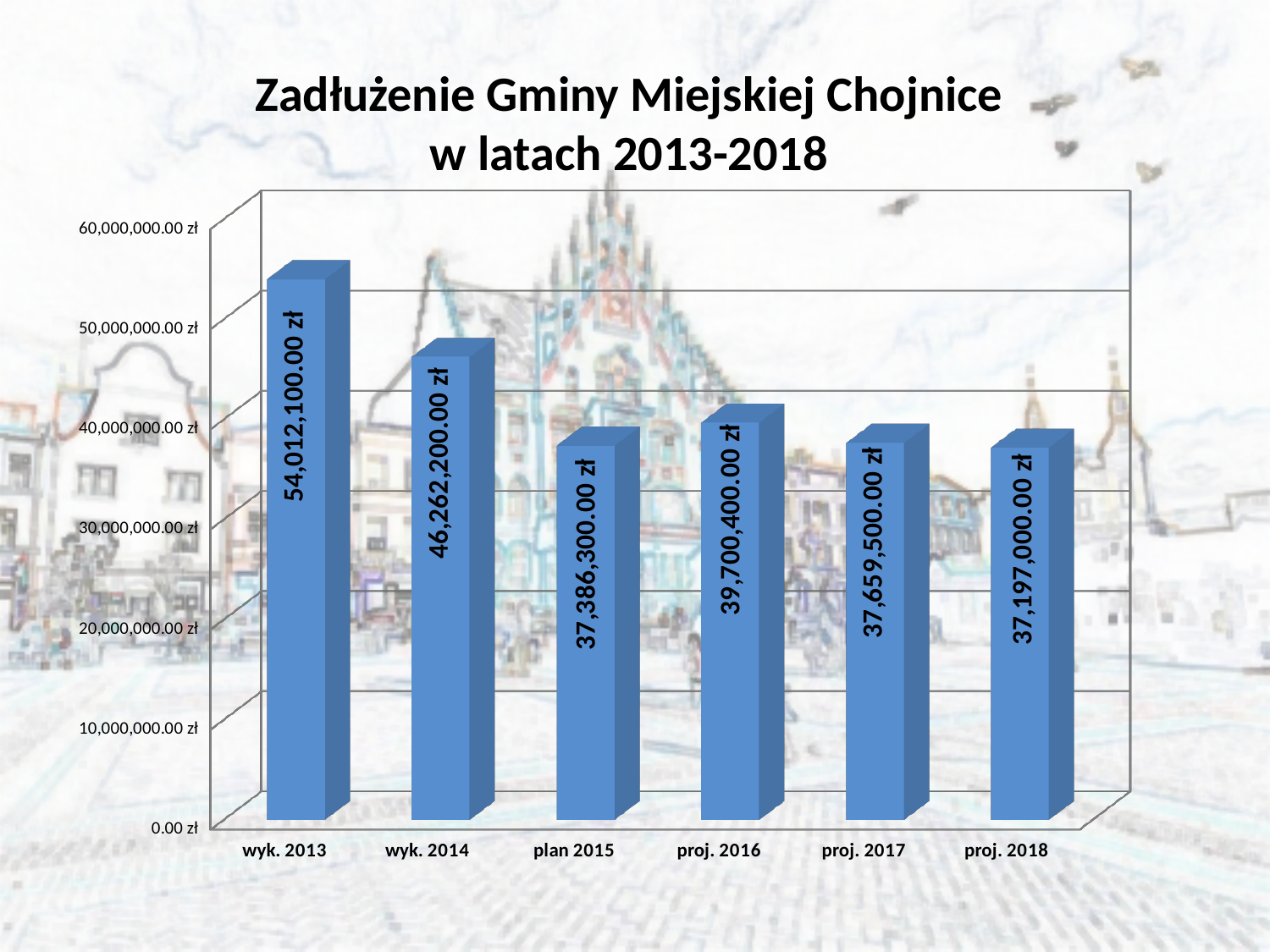
What is the difference between the values for proj. 2016 and plan 2015? 2,314,100.00 zł What is the value for proj. 2018? 37,197,000.00 zł How many categories are shown on the x axis? 6 Is the value for proj. 2017 greater or less than 40,000,000.00 zł? less Overall, do the values rise or fall from wyk. 2013 to proj. 2018? fall Which is larger, the value for wyk. 2014 or the value for proj. 2016? wyk. 2014 What is the difference between the values for wyk. 2013 and wyk. 2014? 7,749,900.00 zł What is the value for wyk. 2013? 54,012,100.00 zł Which category has the highest value? wyk. 2013 Which category has the lowest value? proj. 2018 What kind of chart is shown on the slide? bar chart What is the value for plan 2015? 37,386,300.00 zł